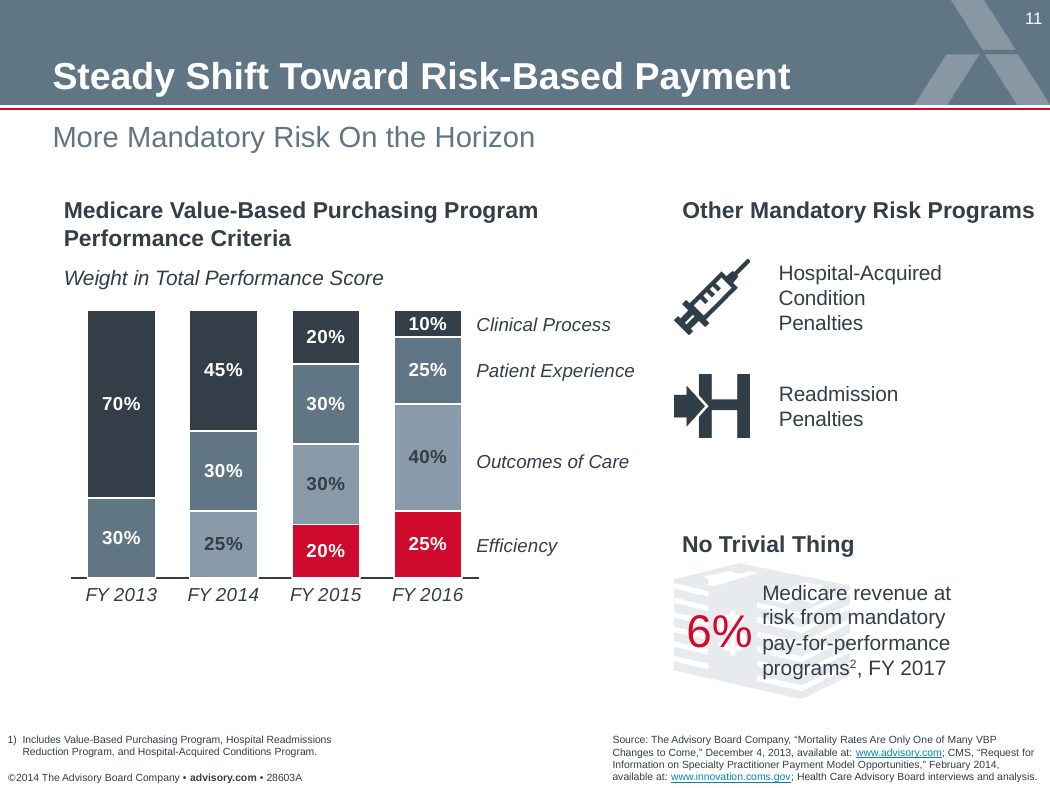
How many fiscal years are shown on the x axis of the chart? 4 By how many percentage points does the Clinical Process weight in FY 2013 exceed that in FY 2016? 60 percentage points Which performance criterion is shown in red in the chart? Efficiency What is the total of the FY 2016 stacked bar? 100% What is the weight of Clinical Process in FY 2013? 70% What is the weight of Efficiency in FY 2016? 25% What kind of chart is shown under "Weight in Total Performance Score"? Stacked bar chart What is the weight of Clinical Process in FY 2014? 45% Which year has the larger Efficiency weight, FY 2015 or FY 2016? FY 2016 Does the weight of Clinical Process rise or fall from FY 2013 to FY 2016? Fall What is the weight of Outcomes of Care in FY 2016? 40% What is the weight of Patient Experience in FY 2015? 30%